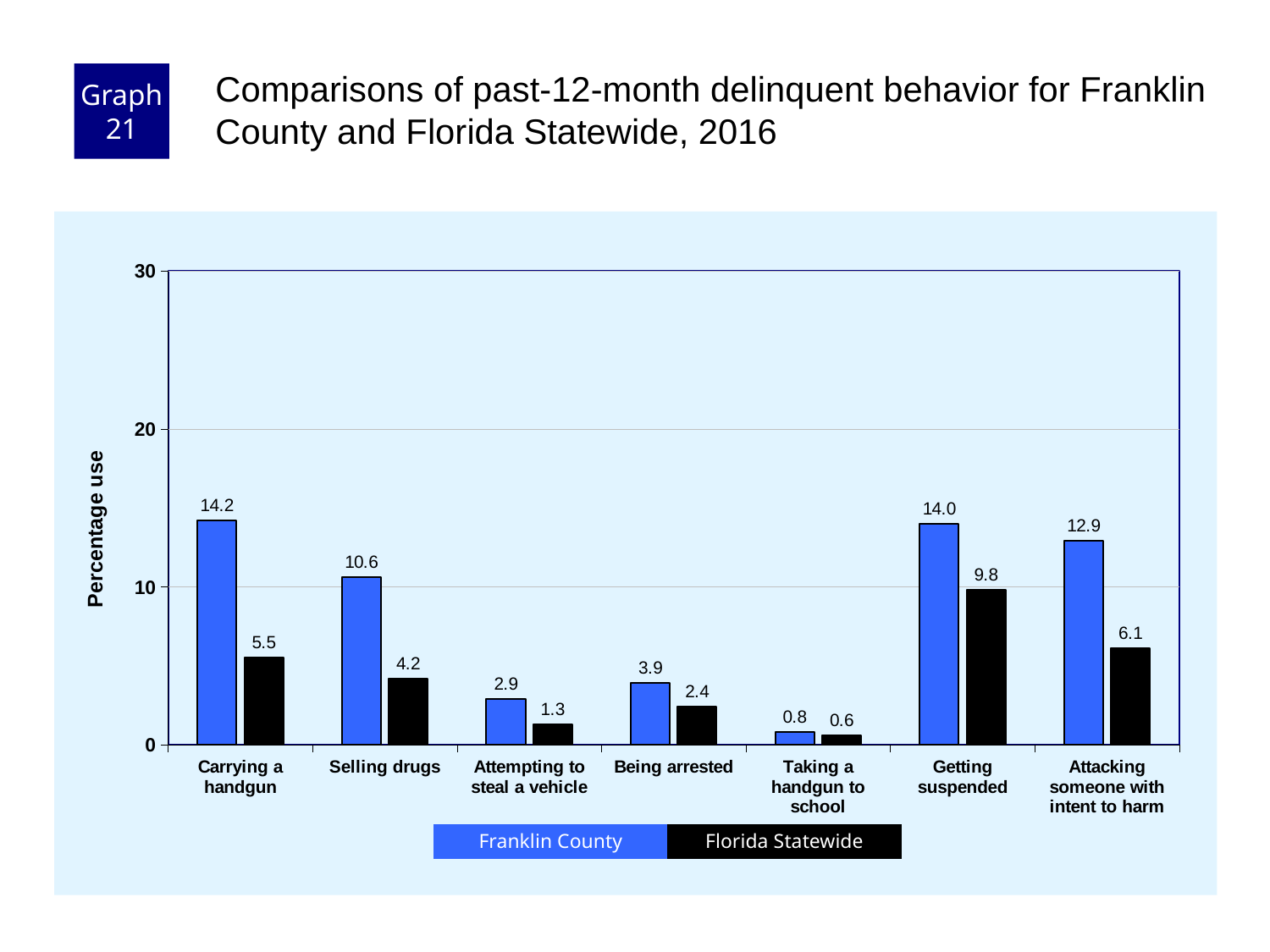
What is the difference between the Franklin County and Florida Statewide values for Selling drugs? 6.4 Which category has the highest Franklin County value? Carrying a handgun How many series does the legend list? 2 What is the Florida Statewide value for Getting suspended? 9.8 How many categories are shown on the x axis? 7 Which category has the lowest Florida Statewide value? Taking a handgun to school What is the Franklin County value for Carrying a handgun? 14.2 What is the label of the y axis? Percentage use What is the Franklin County value for Attacking someone with intent to harm? 12.9 Is the Franklin County value for Getting suspended greater or less than 10? greater Which is larger for Being arrested: the Franklin County value or the Florida Statewide value? Franklin County What kind of chart is shown on the slide? bar chart